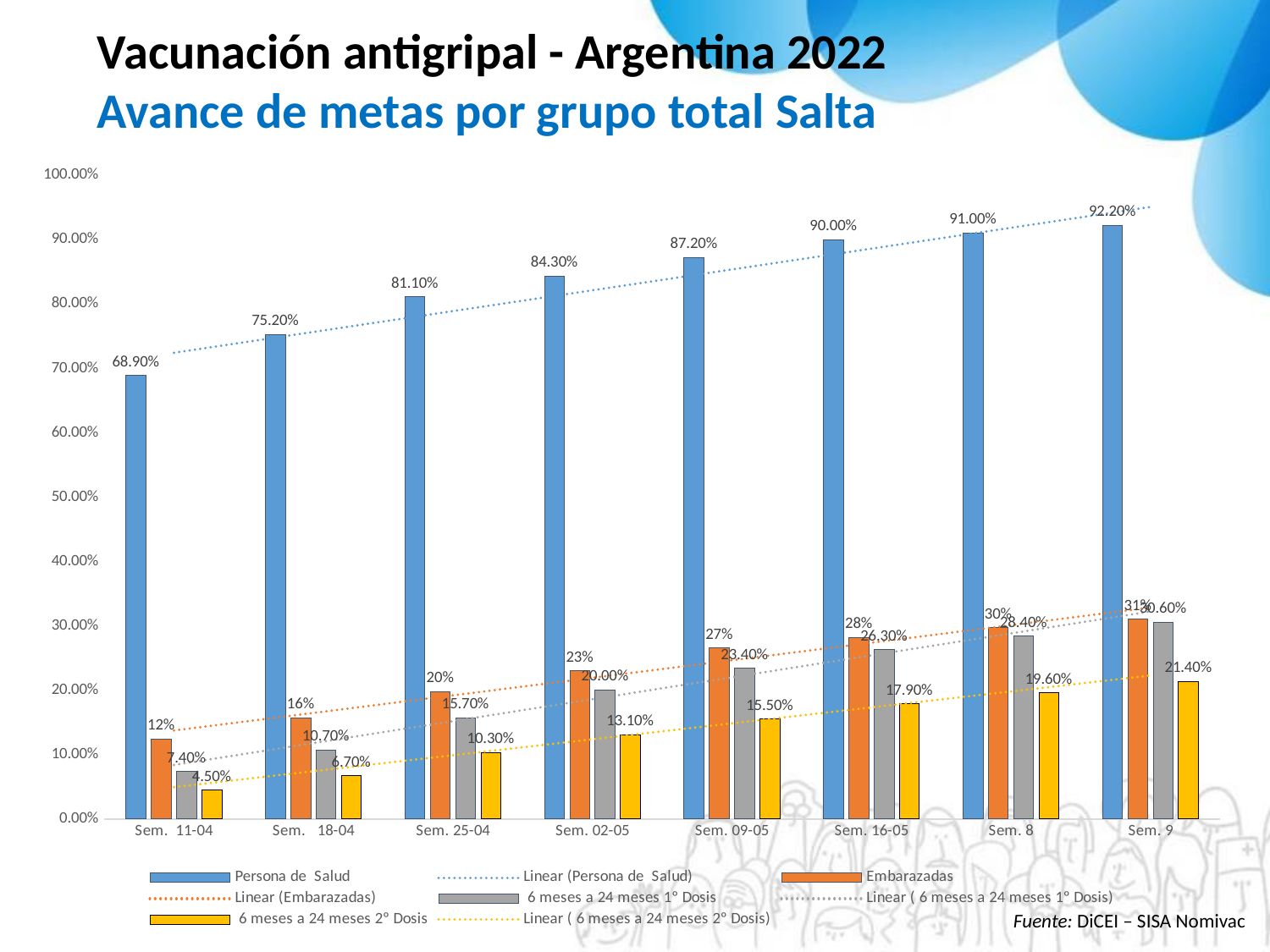
What is the value for Persona de Salud at Sem. 25-04? 81.10% At Sem. 02-05, which is larger: Embarazadas or 6 meses a 24 meses 1° Dosis? Embarazadas In which week does Persona de Salud reach its highest value? Sem. 9 What is the difference between the 6 meses a 24 meses 1° Dosis values at Sem. 9 and Sem. 8? 2.20% What kind of chart is shown on the slide? Bar chart What is the value for 6 meses a 24 meses 1° Dosis at Sem. 02-05? 20.00% Do the Persona de Salud values rise or fall from Sem. 11-04 to Sem. 9? Rise What is the value for 6 meses a 24 meses 2° Dosis at Sem. 16-05? 17.90% What is the value for Embarazadas at Sem. 09-05? 27% In which week is the value for 6 meses a 24 meses 2° Dosis lowest? Sem. 11-04 What is the difference between the Persona de Salud values at Sem. 9 and Sem. 11-04? 23.30% How many weeks (categories) are shown on the x axis? 8